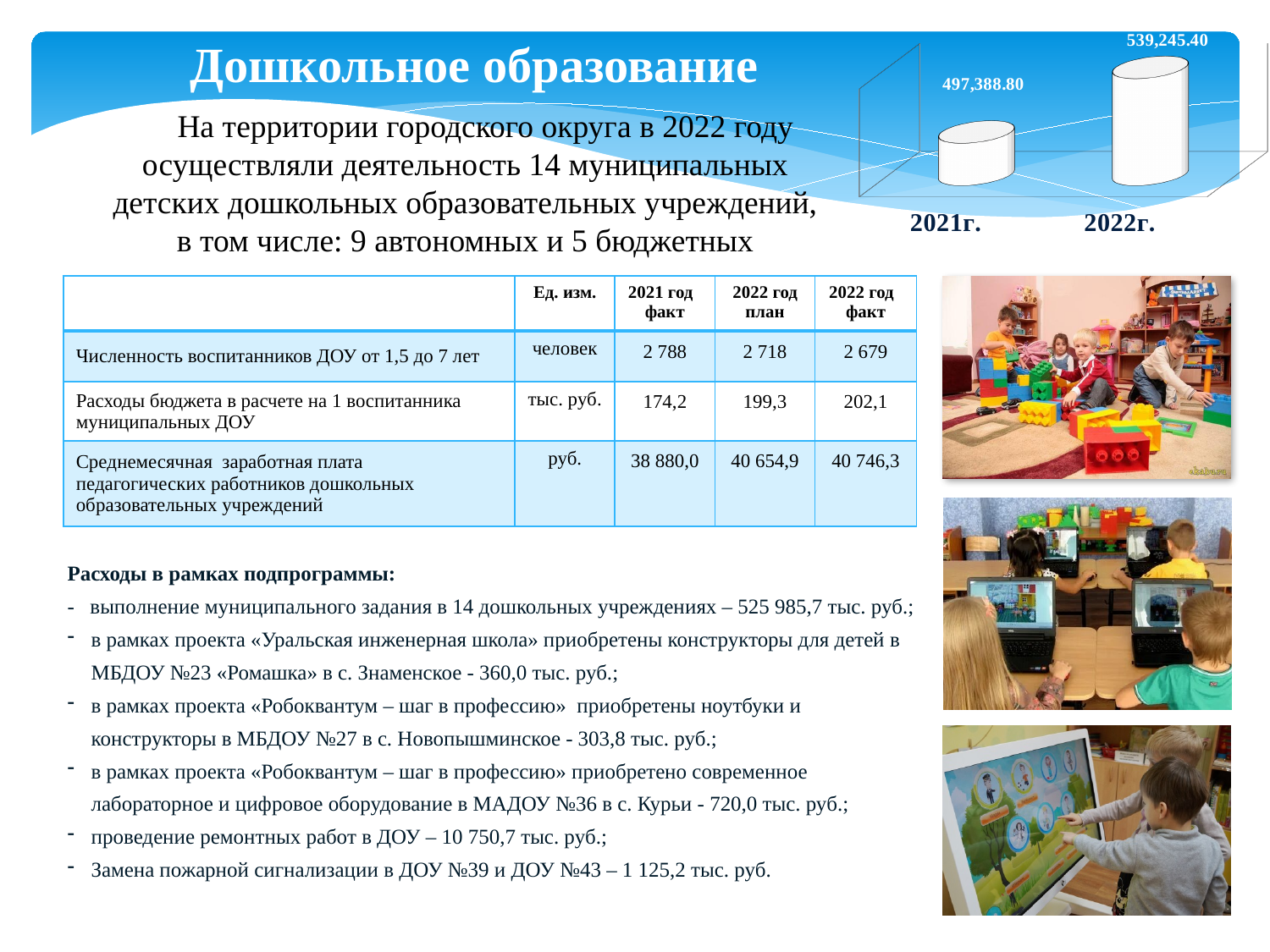
Which year has the higher value in the chart? 2022г. Does the value rise or fall from 2021г. to 2022г. in the chart? rise What is the value shown for 2022г. in the chart? 539,245.40 How many categories are plotted in the chart? 2 What kind of chart is shown in the top right of the slide? bar chart By how much does the value for 2022г. exceed the value for 2021г. in the chart? 41,856.60 What is the value shown for 2021г. in the chart? 497,388.80 Which year has the lower value in the chart? 2021г. What are the two category labels shown under the bars in the chart? 2021г. and 2022г. Is the value for 2022г. larger or smaller than the value for 2021г. in the chart? larger